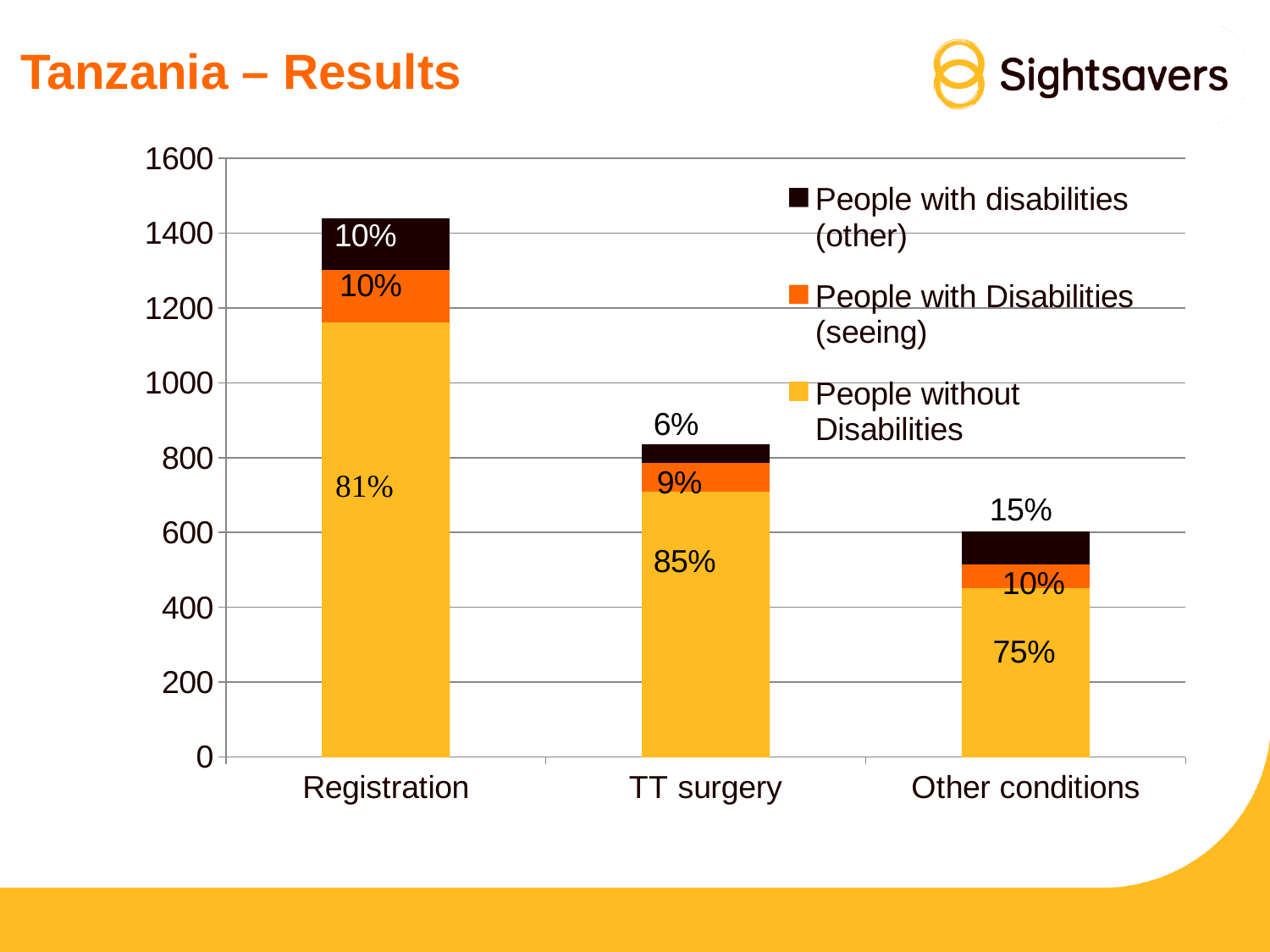
Which category has the shortest stacked bar overall? Other conditions How many series does the legend list? 3 How many categories are shown on the x axis? 3 Is the total height of the Other conditions bar greater or less than 400? greater Is the total height of the Registration bar greater or less than 1400? greater Do the total bar heights rise or fall from Registration to Other conditions along the x axis? fall Is the total height of the TT surgery bar greater or less than 1000? less What percentage label is shown for People with Disabilities (seeing) in the TT surgery bar? 9% Which category has the tallest stacked bar overall? Registration What kind of chart is shown on the slide? Stacked bar chart What percentage label is shown for People with disabilities (other) in the Other conditions bar? 15% What percentage label is shown for People without Disabilities in the TT surgery bar? 85%